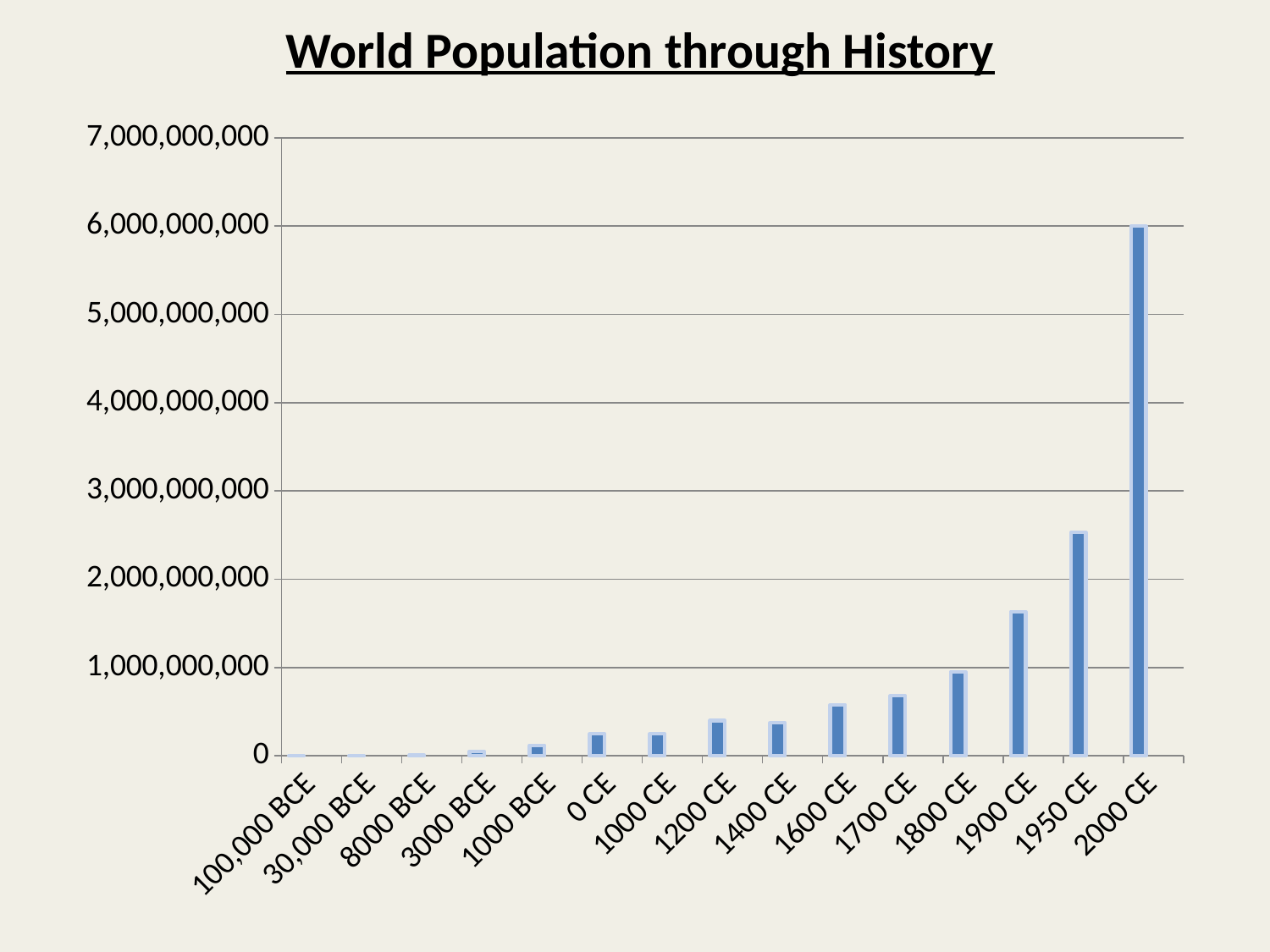
What kind of chart is shown on the slide? bar chart Is the value for 1950 CE greater or less than 2,000,000,000? greater Which is larger, the value for 1700 CE or the value for 1400 CE? 1700 CE How many time periods (categories) are shown on the x axis? 15 Which is larger, the value for 1950 CE or the value for 1900 CE? 1950 CE Is the value for 1900 CE greater or less than 1,000,000,000? greater Is the value for 2000 CE greater or less than 5,000,000,000? greater Which time period has the highest world population? 2000 CE Do the values generally rise or fall moving from left to right along the x axis? rise What is the title of the chart? World Population through History What is the highest value shown on the y axis? 7,000,000,000